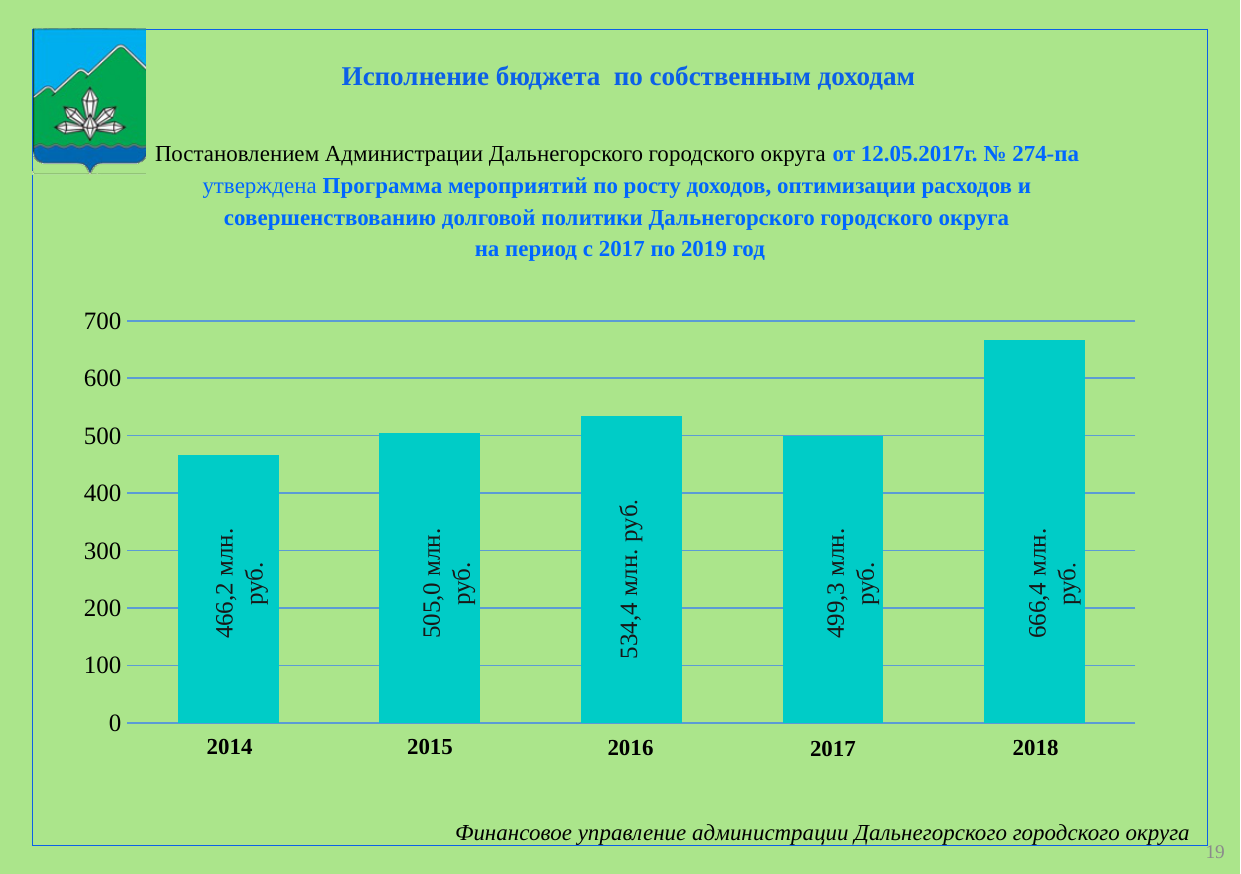
What is the title of the chart? Исполнение бюджета по собственным доходам Is the value for 2017 greater or less than 600? less What is the value for 2018? 666,4 млн. руб. How many years are shown on the x axis? 5 Which year has the highest value? 2018 Which is larger, the value for 2015 or the value for 2017? 2015 What is the value for 2014? 466,2 млн. руб. Which year has the lowest value? 2014 What is the difference between the values for 2016 and 2015? 29,4 млн. руб. What is the difference between the values for 2018 and 2014? 200,2 млн. руб. What kind of chart is shown on the slide? bar chart What is the value for 2016? 534,4 млн. руб.